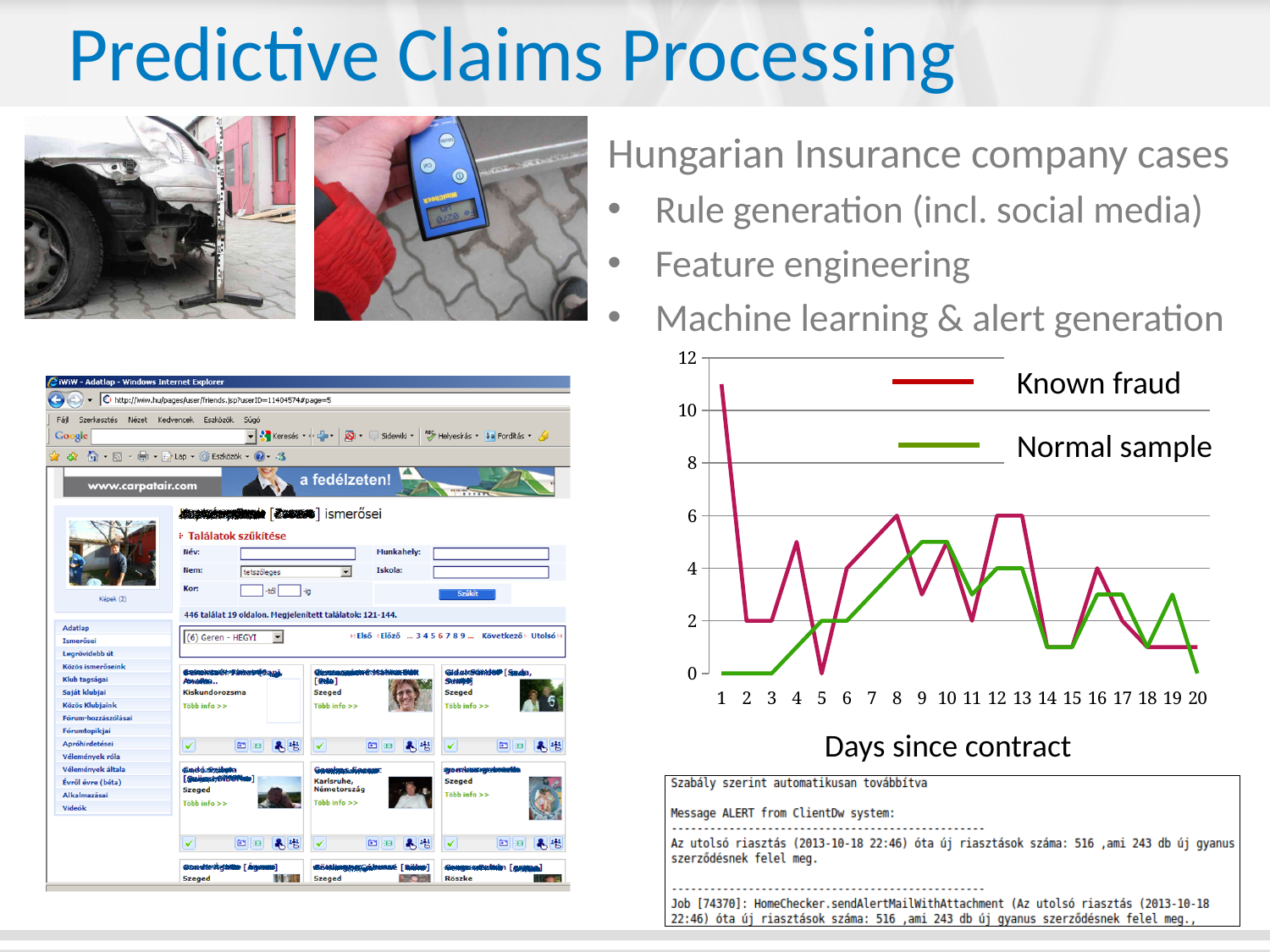
What is the Known fraud value on day 8? 6 On which day since contract is the Known fraud value highest? 1 What is the title of the chart's x axis? Days since contract Which colour is used for the Known fraud series in the chart? red What is the Normal sample value on day 8? 4 Is the Known fraud value on day 1 greater or less than 10? greater What is the Known fraud value on day 5? 0 How many series does the chart's legend list? 2 How many days are plotted along the x axis of the chart? 20 On day 19, which series has the larger value, Known fraud or Normal sample? Normal sample What kind of chart is shown on the slide? line chart What is the difference between the Known fraud and Normal sample values on day 8? 2